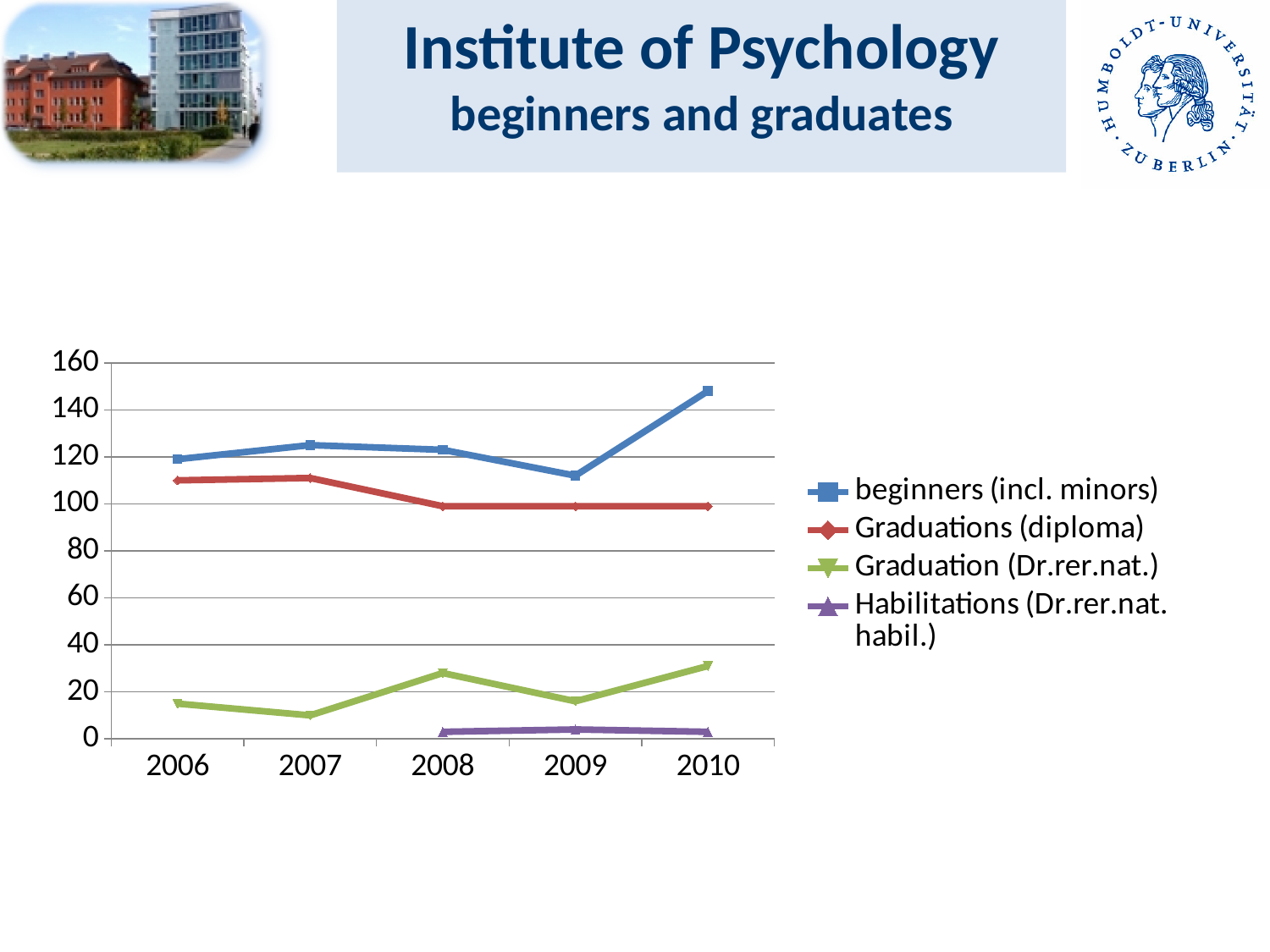
How many series does the legend list? 4 In which year is the value for Graduation (Dr.rer.nat.) lowest? 2007 In which year is the value for beginners (incl. minors) highest? 2010 What kind of chart is shown on the slide? line chart Is the value for beginners (incl. minors) in 2010 greater or less than 140? greater In which year is the value for beginners (incl. minors) lowest? 2009 Is the value for Graduations (diploma) in 2006 greater or less than 100? greater Does the value for Graduations (diploma) rise or fall from 2006 to 2010? fall Is the value for Graduation (Dr.rer.nat.) in 2007 greater or less than 20? less How many years are shown on the x axis? 5 In 2010, which is larger: beginners (incl. minors) or Graduations (diploma)? beginners (incl. minors)